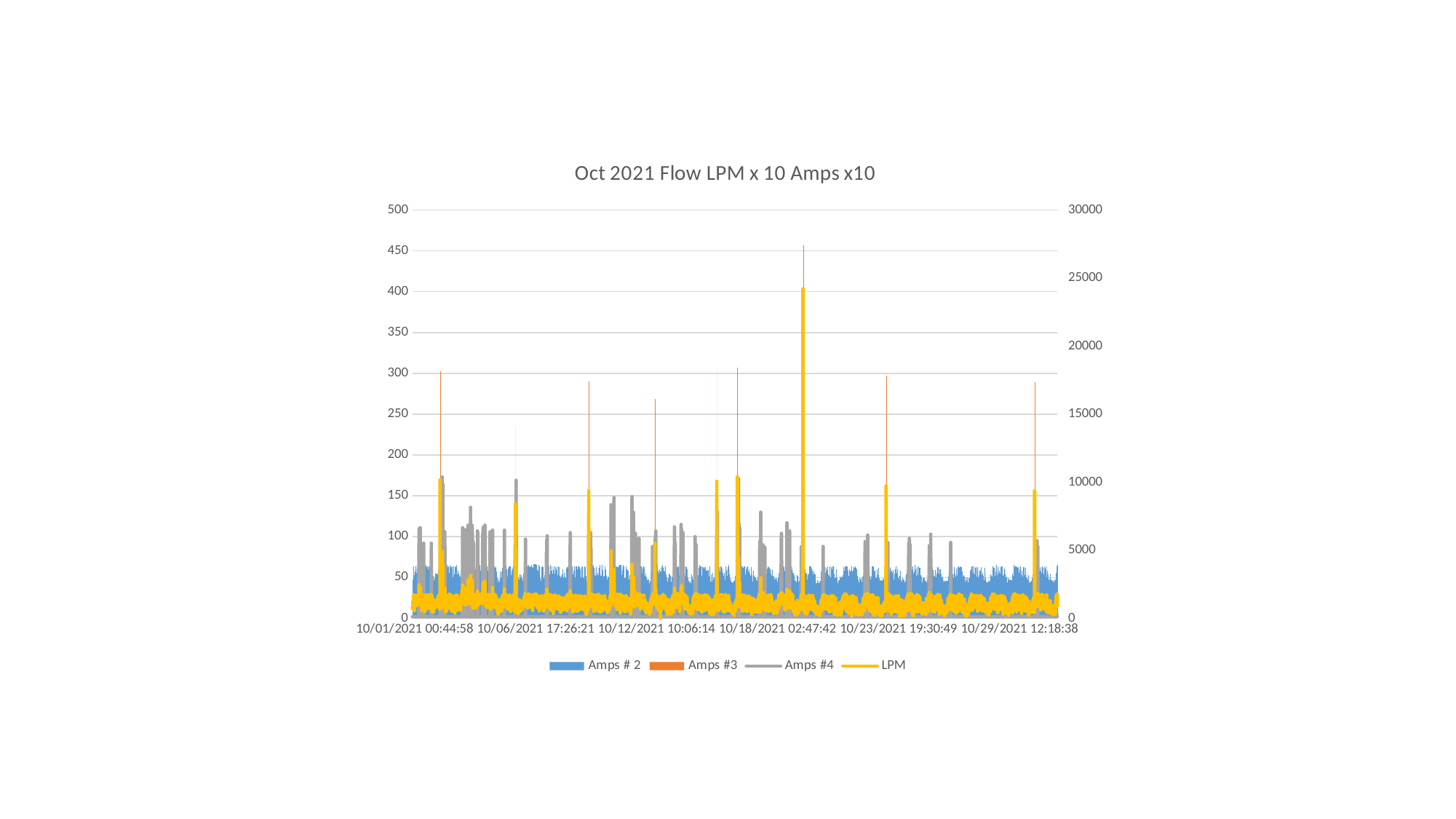
What is the title of the chart? Oct 2021 Flow LPM x 10 Amps x10 Which series reaches the highest peak on the left axis, Amps #3 or Amps #4? Amps #3 How many series does the legend list? 4 Is the highest peak of the LPM series greater or less than 20000 on the right axis? greater Is the highest peak of the Amps #4 series greater or less than 250 on the left axis? greater Which colour is used for the LPM series in the legend? yellow Is the highest peak of the Amps #3 series greater or less than 400 on the left axis? greater What kind of chart is shown on the slide? line chart How many date labels are shown along the x axis? 6